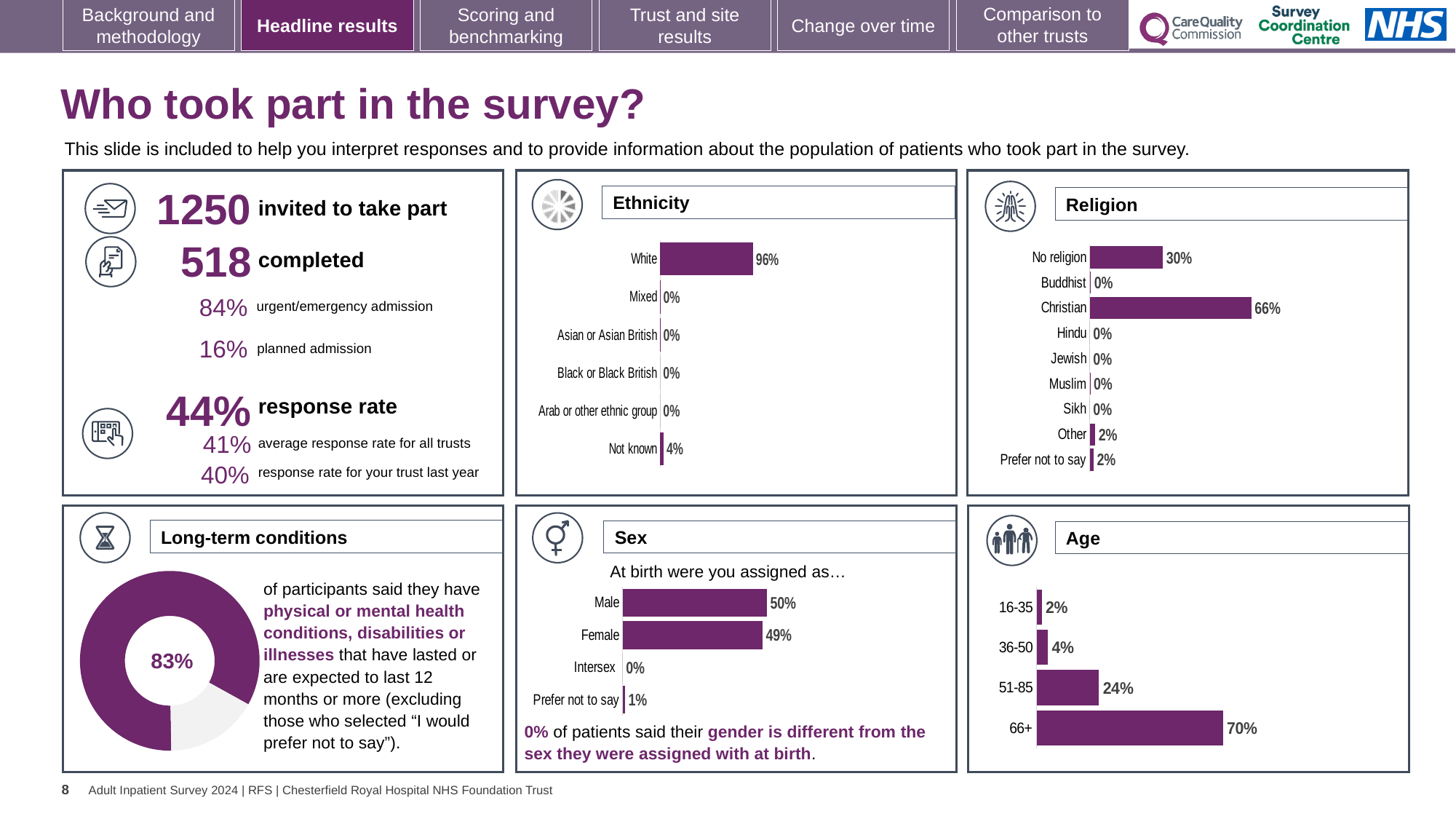
In the Sex chart, what is the value for Prefer not to say? 1% In the Religion chart, what is the value for No religion? 30% In the Religion chart, how many categories are shown? 9 In the Religion chart, which category has the highest value? Christian In the Age chart, which age group has the highest value? 66+ In the Sex chart, which is larger, Male or Female? Male In the Religion chart, what is the difference between Christian and No religion? 36% In the Age chart, what is the value for 51-85? 24% In the Long-term conditions chart, what share of participants said they have long-term conditions? 83% In the Ethnicity chart, what percentage of respondents are Not known? 4% In the Ethnicity chart, what percentage of respondents are White? 96% In the Age chart, do the values rise or fall as you go from 16-35 to 66+? rise